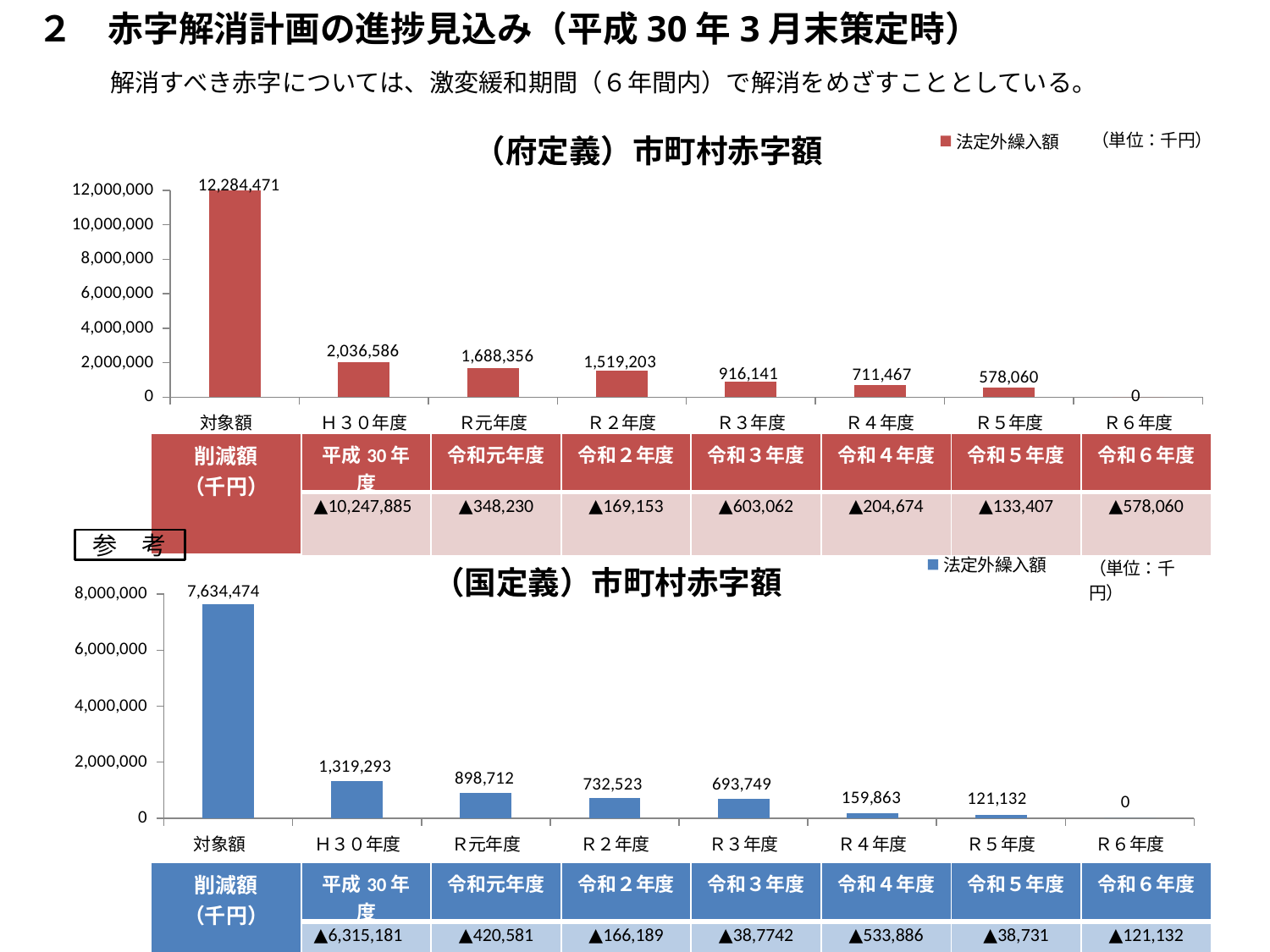
How many categories are shown on the x axis of the （府定義）市町村赤字額 chart? 8 In the （国定義）市町村赤字額 chart, what is the value for Ｒ４年度? 159,863 In the （国定義）市町村赤字額 chart, which category has the highest value? 対象額 In the （府定義）市町村赤字額 chart, which category has the lowest value? Ｒ６年度 In the （国定義）市町村赤字額 chart, which is larger, the value for Ｒ３年度 or the value for Ｒ４年度? Ｒ３年度 In the （府定義）市町村赤字額 chart, what is the value for Ｒ５年度? 578,060 Do the values in the （国定義）市町村赤字額 chart rise or fall from Ｈ３０年度 to Ｒ６年度? fall In the （府定義）市町村赤字額 chart, what is the value for 対象額? 12,284,471 In the （府定義）市町村赤字額 chart, what is the difference between the values for Ｈ３０年度 and Ｒ元年度? 348,230 In the （国定義）市町村赤字額 chart, what is the value for 対象額? 7,634,474 In the （国定義）市町村赤字額 chart, what is the difference between the values for Ｒ元年度 and Ｒ２年度? 166,189 In the （府定義）市町村赤字額 chart, what is the value for Ｒ３年度? 916,141